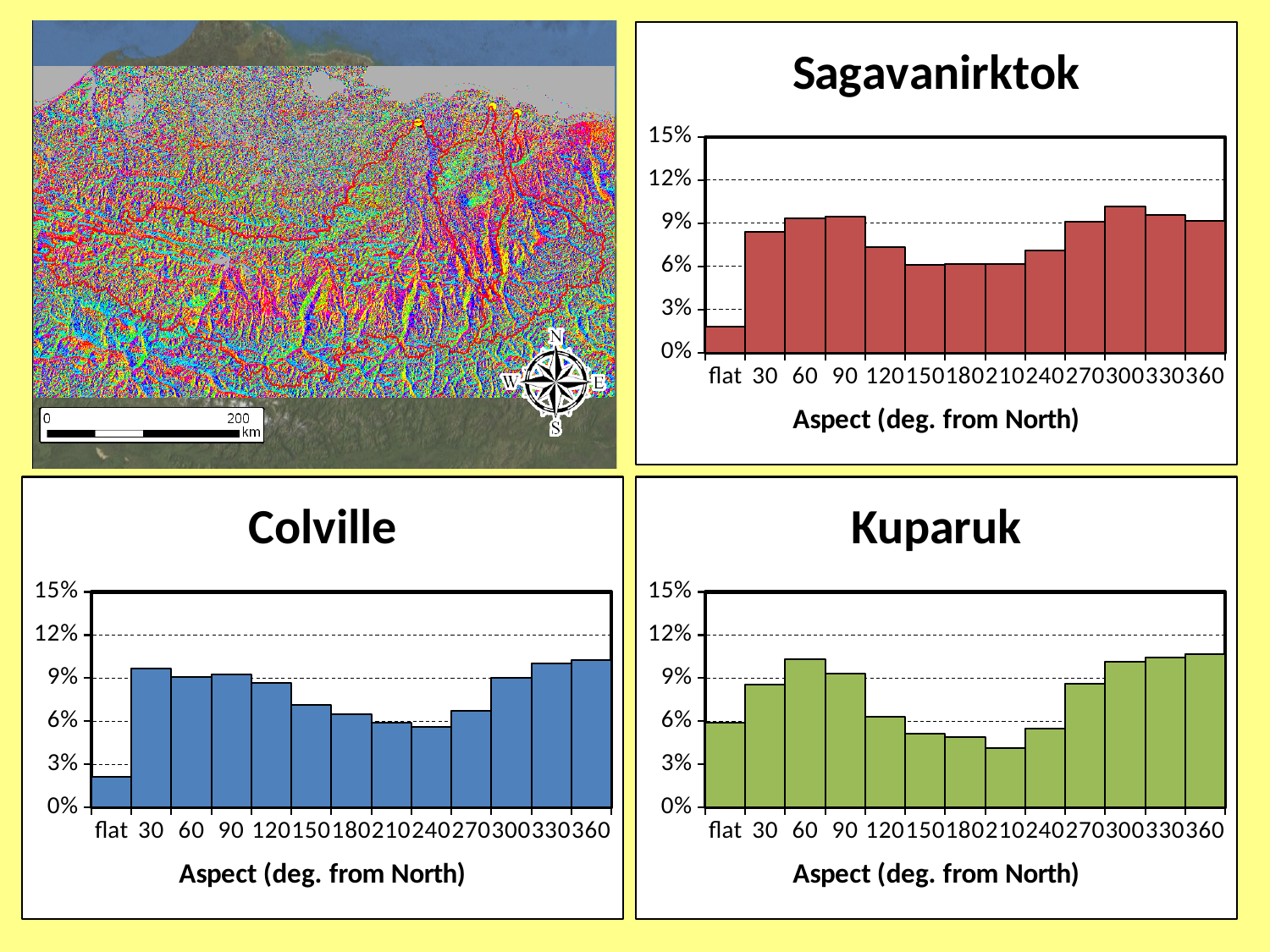
In the Kuparuk chart, do the values rise or fall going from 60 to 210 along the x axis? fall In the Sagavanirktok chart, which is larger, the value for 30 or the value for 120? 30 In the Kuparuk chart, is the value for 60 greater or less than 9%? greater What kind of chart is the Sagavanirktok chart? bar chart In the Colville chart, is the value for 240 greater or less than 6%? less In the Sagavanirktok chart, which aspect category has the highest value? 300 How many aspect categories are shown on the x axis of the Colville chart? 13 In the Sagavanirktok chart, which aspect category has the lowest value? flat In the Colville chart, which aspect category has the lowest value? flat What is the x-axis title of the Kuparuk chart? Aspect (deg. from North) In the Sagavanirktok chart, is the value for 300 greater or less than 9%? greater In the Kuparuk chart, which aspect category has the lowest value? 210